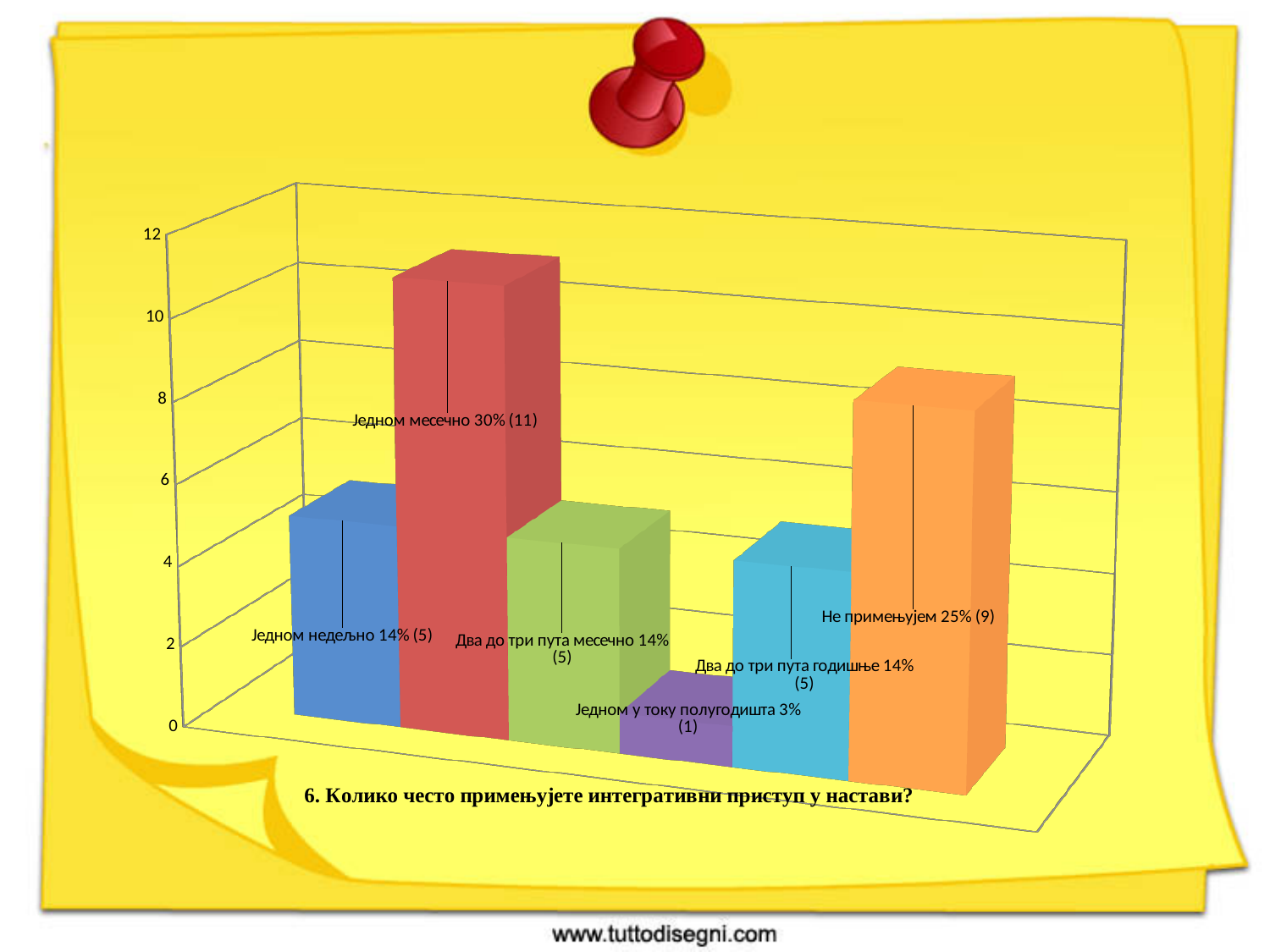
What percentage is shown for "Једном недељно"? 14% Is the value for "Једном месечно" greater or less than 10? greater What is the count shown for "Једном месечно"? 11 How many categories (bars) does the chart show? 6 Which is larger, the value for "Не примењујем" or the value for "Два до три пута годишње"? Не примењујем Which category has the highest value? Једном месечно Which category has the lowest value? Једном у току полугодишта What is the difference in count between "Једном месечно" and "Не примењујем"? 2 What is the count shown for "Једном у току полугодишта"? 1 What percentage is shown for "Не примењујем"? 25% What is the title of the chart? 6. Колико често примењујете интегративни приступ у настави? What kind of chart is shown on the slide? Bar chart